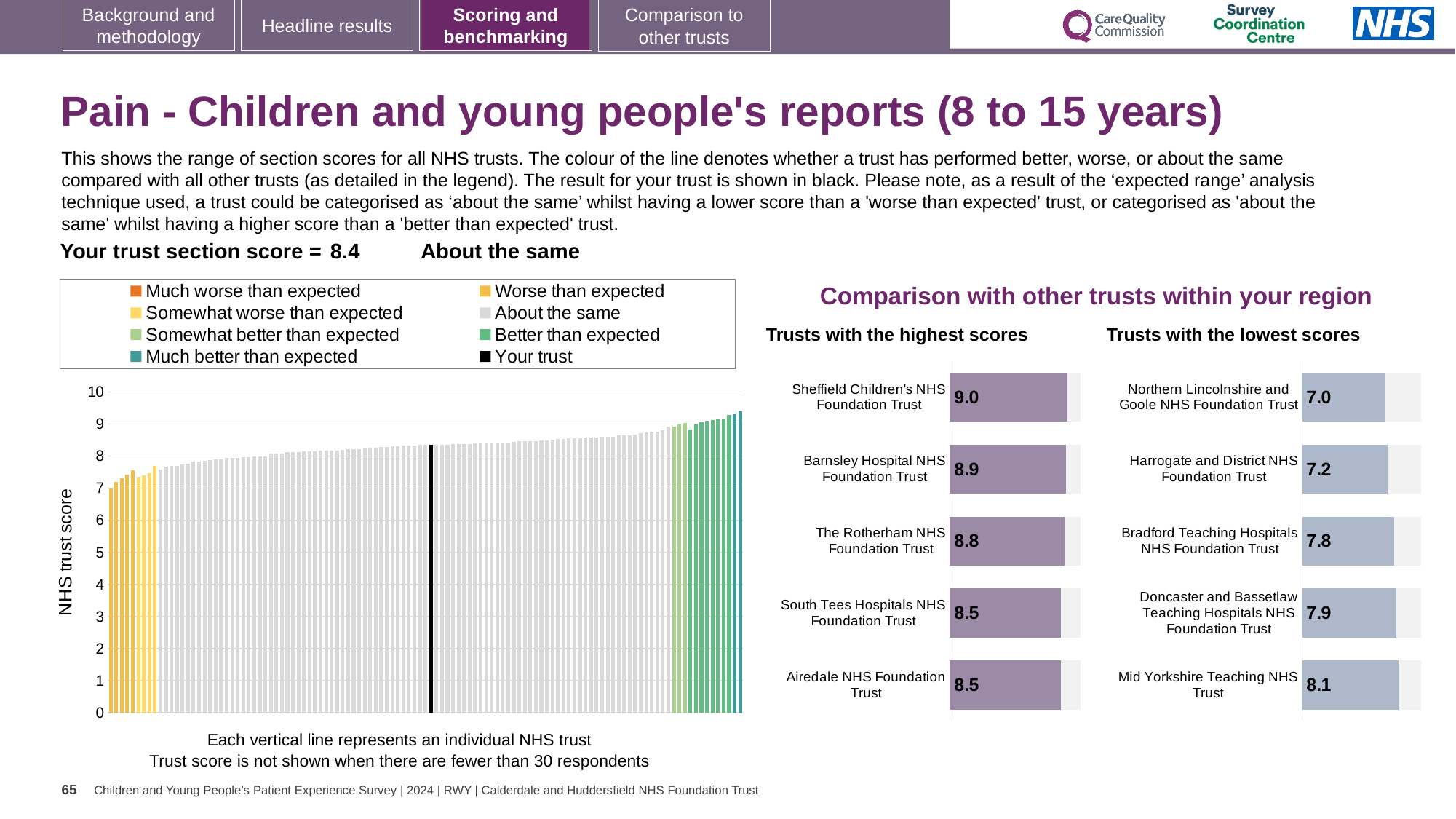
What kind of chart is the large chart on the left showing NHS trust scores? Bar chart In the 'Trusts with the highest scores' chart, what is the difference between the scores of Sheffield Children's NHS Foundation Trust and Barnsley Hospital NHS Foundation Trust? 0.1 In the 'Trusts with the highest scores' chart, what is the score for Sheffield Children's NHS Foundation Trust? 9.0 How many trusts are listed in the 'Trusts with the lowest scores' chart? 5 In the 'Trusts with the lowest scores' chart, which has the larger score: Bradford Teaching Hospitals NHS Foundation Trust or Harrogate and District NHS Foundation Trust? Bradford Teaching Hospitals NHS Foundation Trust In the large chart on the left, is the value for the black bar (your trust) greater or less than 8? greater In the 'Trusts with the highest scores' chart, what is the score for The Rotherham NHS Foundation Trust? 8.8 How many entries does the legend above the large chart on the left list? 8 In the 'Trusts with the lowest scores' chart, which trust has the lowest score? Northern Lincolnshire and Goole NHS Foundation Trust In the 'Trusts with the highest scores' chart, which trust has the highest score? Sheffield Children's NHS Foundation Trust In the 'Trusts with the lowest scores' chart, what is the difference between the scores of Mid Yorkshire Teaching NHS Trust and Northern Lincolnshire and Goole NHS Foundation Trust? 1.1 In the 'Trusts with the lowest scores' chart, what is the score for Harrogate and District NHS Foundation Trust? 7.2